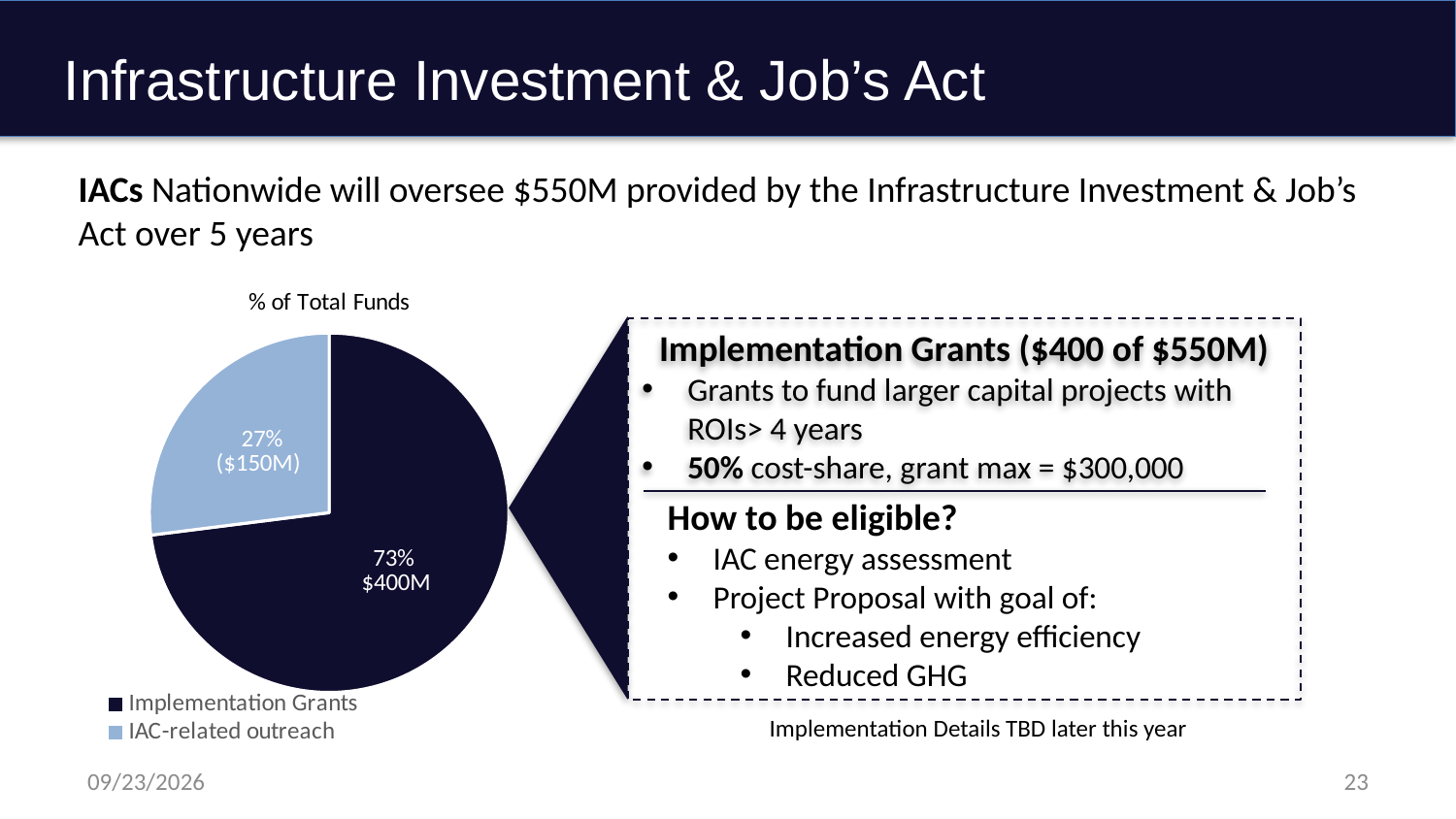
What dollar amount is labelled on the Implementation Grants slice? $400M What is the difference in percentage points between the Implementation Grants slice and the IAC-related outreach slice? 46 What kind of chart is shown on the slide? pie chart What percentage of total funds goes to IAC-related outreach? 27% What percentage of total funds goes to Implementation Grants? 73% Which legend entry is shown in light blue? IAC-related outreach How many entries does the chart legend list? 2 What is the title of the chart? % of Total Funds What dollar amount is labelled on the IAC-related outreach slice? $150M Which slice of the pie chart is the smallest? IAC-related outreach How many slices does the pie chart have? 2 Which slice of the pie chart is the largest? Implementation Grants